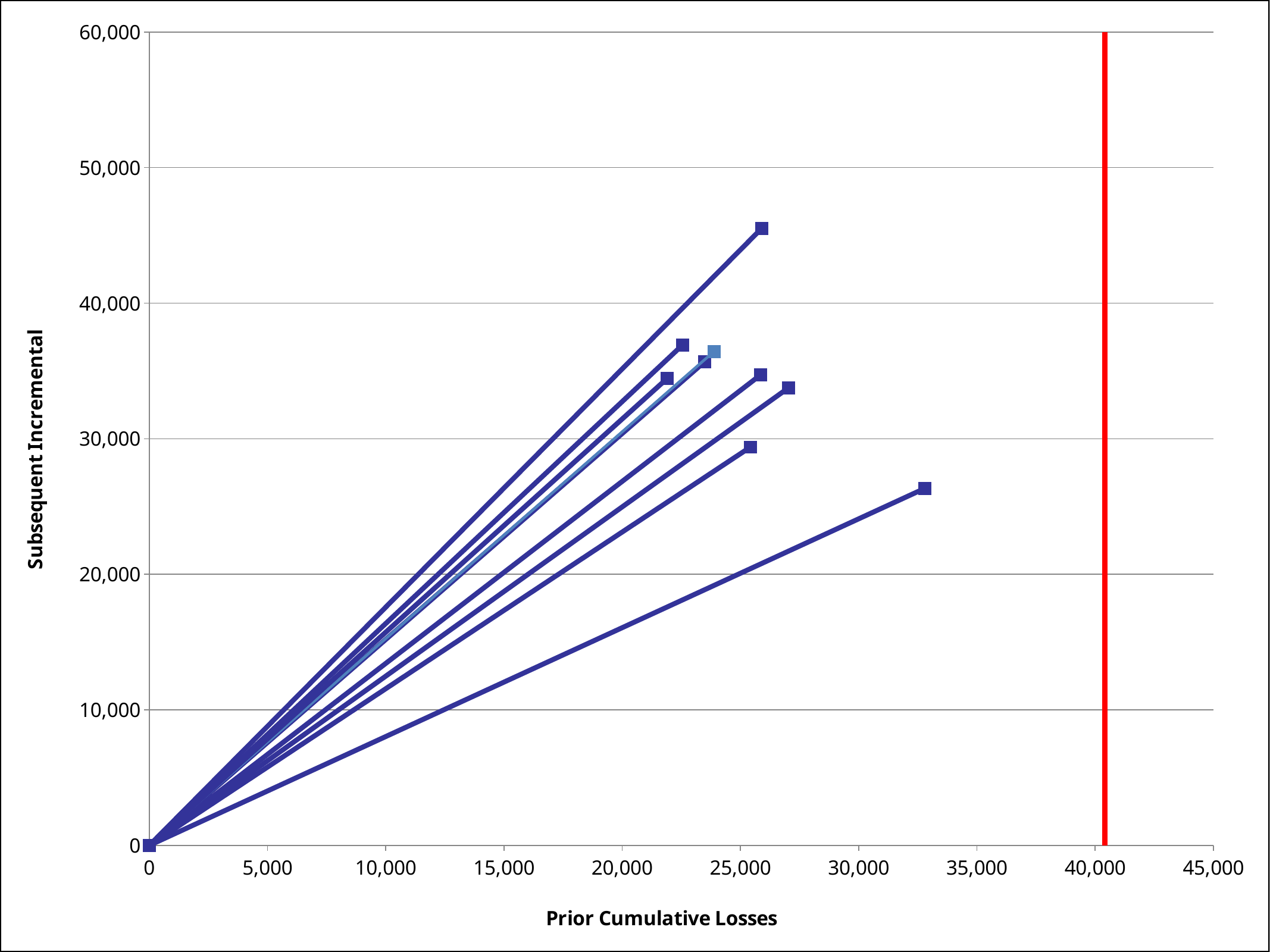
What is the highest value shown on the x axis? 45,000 What is the title of the y axis? Subsequent Incremental Do the blue lines rise or fall as Prior Cumulative Losses increase? rise Is the highest endpoint of the blue lines greater or less than 40,000 on the y axis? greater Is the red vertical line positioned at a Prior Cumulative Losses value greater or less than 40,000? greater What is the title of the x axis? Prior Cumulative Losses Is the red vertical line positioned at a Prior Cumulative Losses value greater or less than 45,000? less What kind of chart is shown on the slide? line chart How many blue lines are plotted from the origin? 9 At what value on the x axis do all the blue lines start? 0 What is the highest value shown on the y axis? 60,000